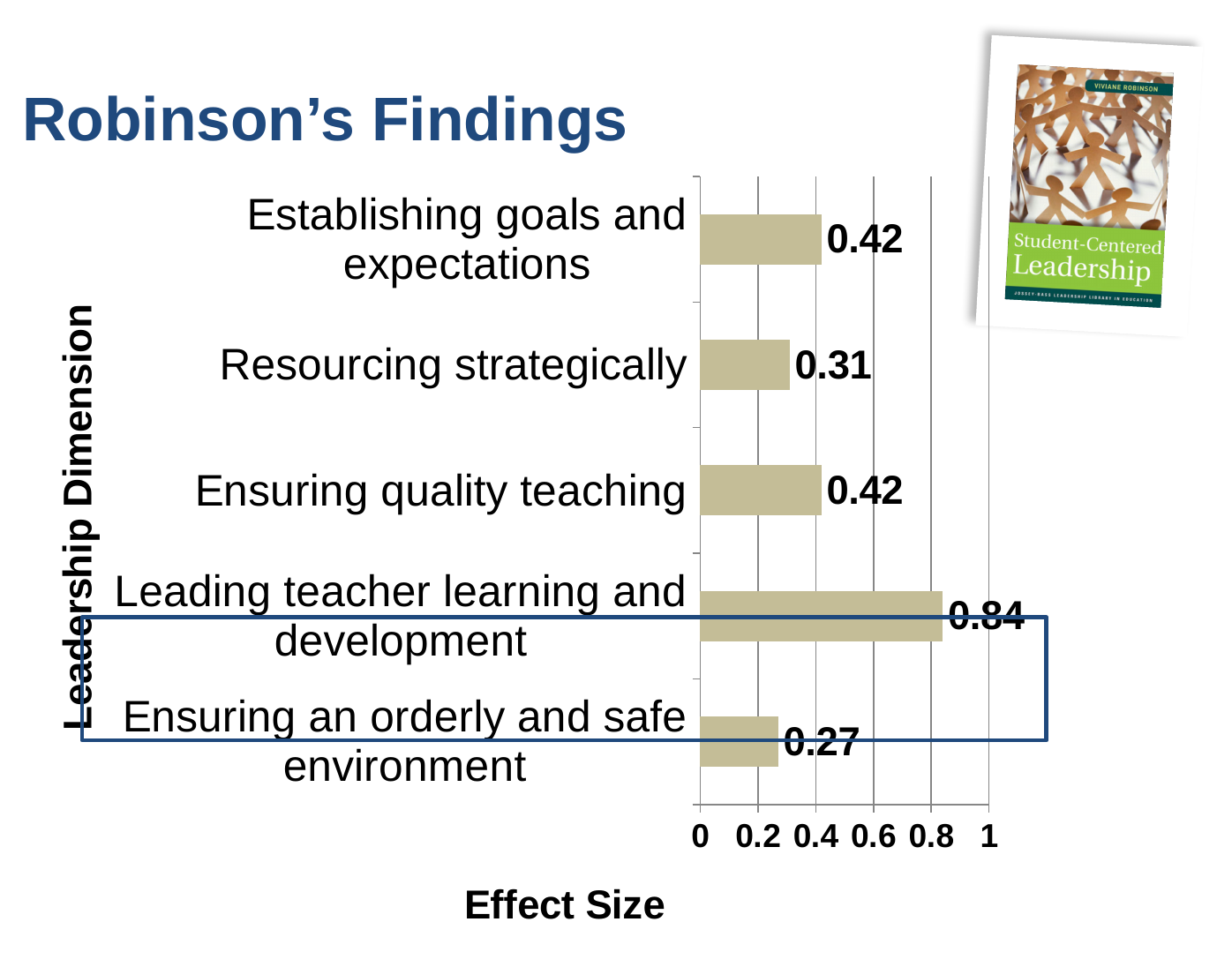
What is the effect size for Ensuring an orderly and safe environment? 0.27 Is the effect size for Leading teacher learning and development greater or less than 0.8? greater What kind of chart is shown on the slide? Bar chart How many leadership dimensions are shown in the chart? 5 Which leadership dimension has the highest effect size? Leading teacher learning and development What is the label of the horizontal axis? Effect Size What is the effect size for Leading teacher learning and development? 0.84 What is the difference in effect size between Leading teacher learning and development and Ensuring quality teaching? 0.42 Which has a larger effect size, Resourcing strategically or Ensuring an orderly and safe environment? Resourcing strategically Which leadership dimension has the lowest effect size? Ensuring an orderly and safe environment What is the effect size for Resourcing strategically? 0.31 What is the effect size for Establishing goals and expectations? 0.42